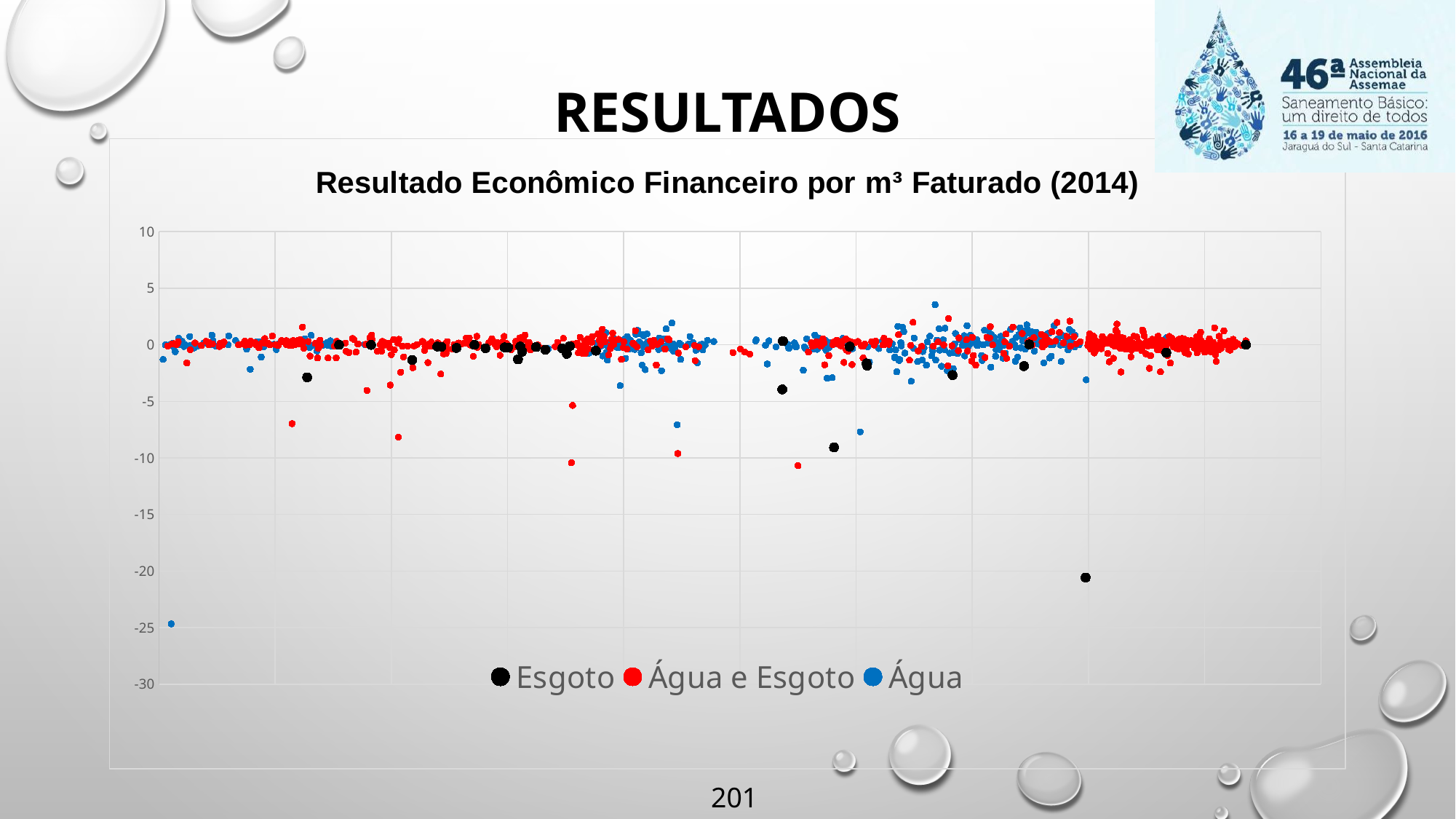
Which series has the lowest point: Esgoto or Água e Esgoto? Esgoto What is the title of the chart? Resultado Econômico Financeiro por m³ Faturado (2014) Is the lowest plotted point of the Água series greater or less than -20? less Is the highest plotted point on the chart greater or less than 5? less Is the lowest plotted point of the Água e Esgoto series greater or less than -15? greater Which series has the lowest plotted point on the chart? Água What kind of chart is shown on the slide? scatter chart Which series is plotted in blue? Água How many series does the legend list? 3